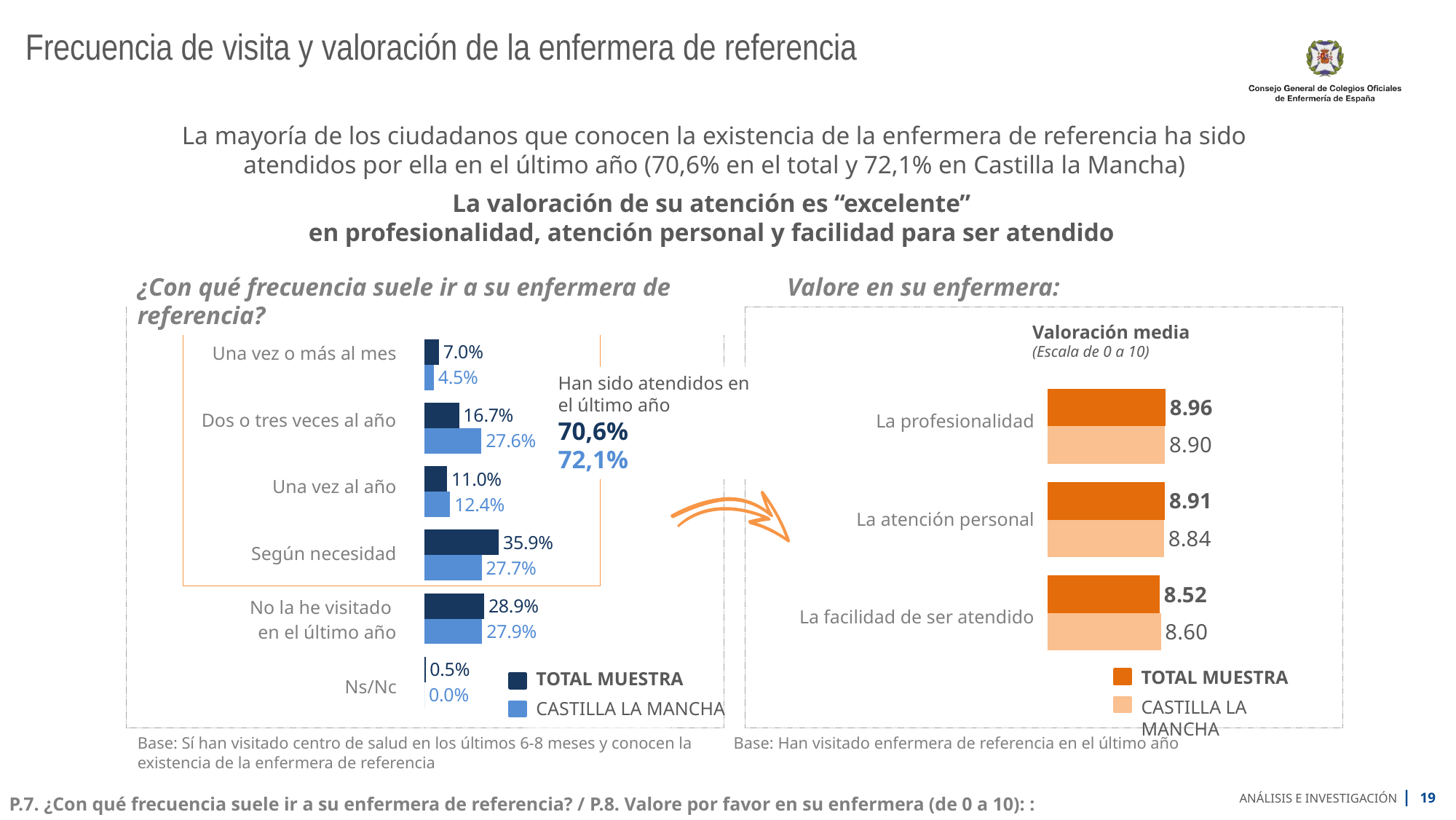
How many categories are shown in the left chart (¿Con qué frecuencia suele ir a su enfermera de referencia?)? 6 What kind of chart is the right chart (Valore en su enfermera)? Bar chart In the right chart (Valore en su enfermera), what is the difference between the TOTAL MUESTRA and CASTILLA LA MANCHA values for 'La profesionalidad'? 0.06 In the left chart (¿Con qué frecuencia suele ir a su enfermera de referencia?), what is the TOTAL MUESTRA value for 'Según necesidad'? 35.9% In the left chart (¿Con qué frecuencia suele ir a su enfermera de referencia?), which category has the highest TOTAL MUESTRA value? Según necesidad In the right chart (Valore en su enfermera), which is larger for 'La facilidad de ser atendido': TOTAL MUESTRA or CASTILLA LA MANCHA? CASTILLA LA MANCHA In the left chart (¿Con qué frecuencia suele ir a su enfermera de referencia?), what is the CASTILLA LA MANCHA value for 'Dos o tres veces al año'? 27.6% How many series does the legend of the left chart (¿Con qué frecuencia suele ir a su enfermera de referencia?) list? 2 In the right chart (Valore en su enfermera), what is the TOTAL MUESTRA value for 'La atención personal'? 8.91 In the left chart (¿Con qué frecuencia suele ir a su enfermera de referencia?), which category has the lowest CASTILLA LA MANCHA value? Ns/Nc In the left chart (¿Con qué frecuencia suele ir a su enfermera de referencia?), what is the difference between the TOTAL MUESTRA and CASTILLA LA MANCHA values for 'Dos o tres veces al año'? 10.9% In the left chart (¿Con qué frecuencia suele ir a su enfermera de referencia?), which is larger for 'Una vez al año': TOTAL MUESTRA or CASTILLA LA MANCHA? CASTILLA LA MANCHA